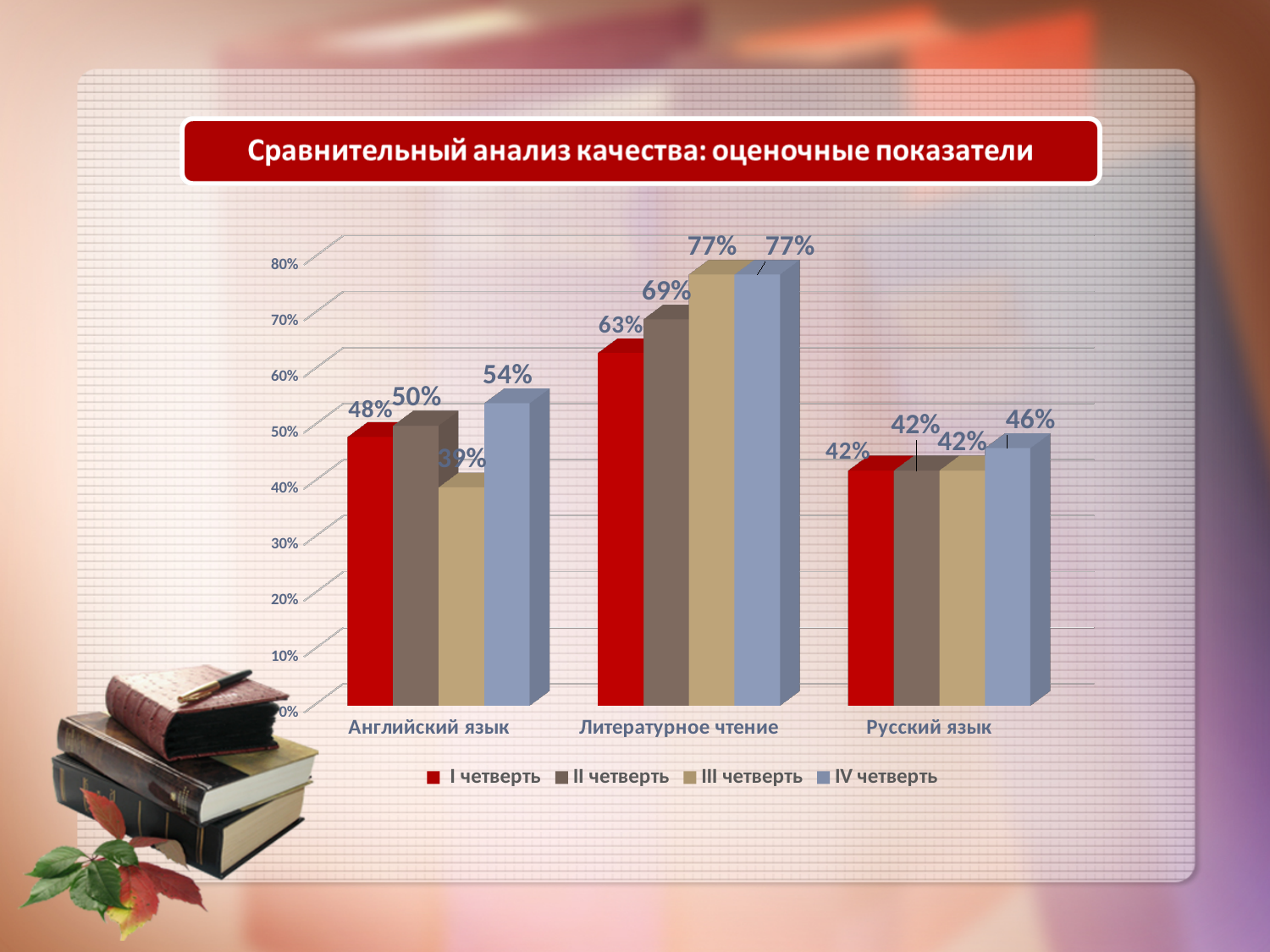
What is the value for I четверть in Английский язык? 48% Which is larger: the II четверть value for Английский язык or the II четверть value for Русский язык? Английский язык What is the title of the slide? Сравнительный анализ качества: оценочные показатели How many series does the legend list? 4 What is the difference between the IV четверть and I четверть values for Литературное чтение? 14% What is the value for III четверть in Литературное чтение? 77% Which series has the lowest value in Английский язык? III четверть What is the value for III четверть in Английский язык? 39% How many categories are shown on the x axis? 3 What kind of chart is shown on the slide? Bar chart What is the value for IV четверть in Русский язык? 46% Which category has the highest value for IV четверть? Литературное чтение